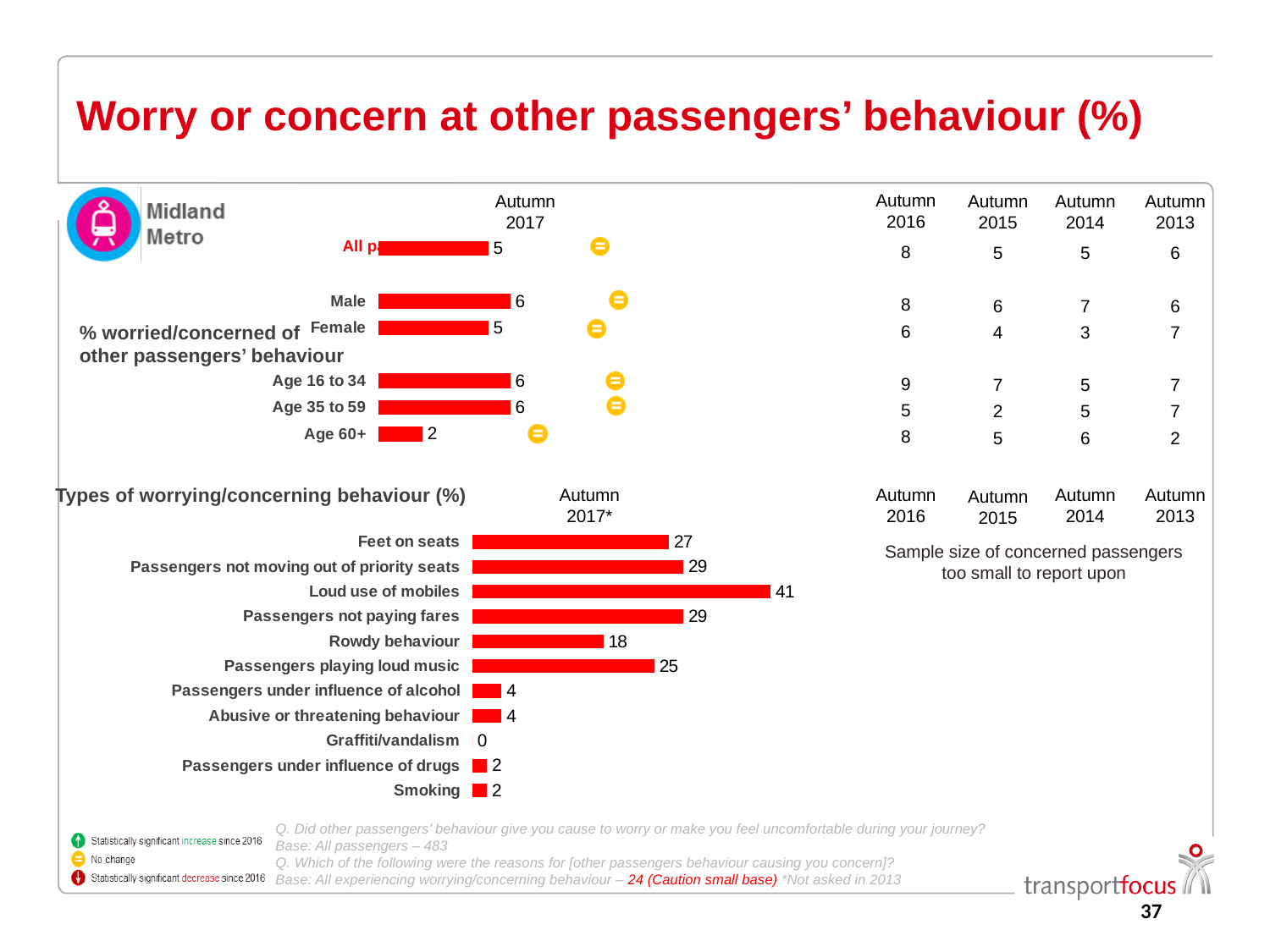
How many categories are shown in the 'Types of worrying/concerning behaviour (%)' chart? 11 What type of chart is the 'Types of worrying/concerning behaviour (%)' chart? Bar chart In the 'Types of worrying/concerning behaviour (%)' chart, which category has the lowest value? Graffiti/vandalism In the top chart '% worried/concerned of other passengers' behaviour', what is the Autumn 2017 value for Age 60+? 2 In the top chart '% worried/concerned of other passengers' behaviour', which age group has the lowest Autumn 2017 value? Age 60+ In the 'Types of worrying/concerning behaviour (%)' chart, what is the value for Loud use of mobiles? 41 In the 'Types of worrying/concerning behaviour (%)' chart, what is the value for Rowdy behaviour? 18 In the 'Types of worrying/concerning behaviour (%)' chart, which category has the highest value? Loud use of mobiles In the 'Types of worrying/concerning behaviour (%)' chart, what is the difference between Loud use of mobiles and Feet on seats? 14 In the 'Types of worrying/concerning behaviour (%)' chart, which is larger: Passengers playing loud music or Rowdy behaviour? Passengers playing loud music In the 'Types of worrying/concerning behaviour (%)' chart, what is the value for Smoking? 2 In the top chart '% worried/concerned of other passengers' behaviour', what is the Autumn 2017 value for Male? 6